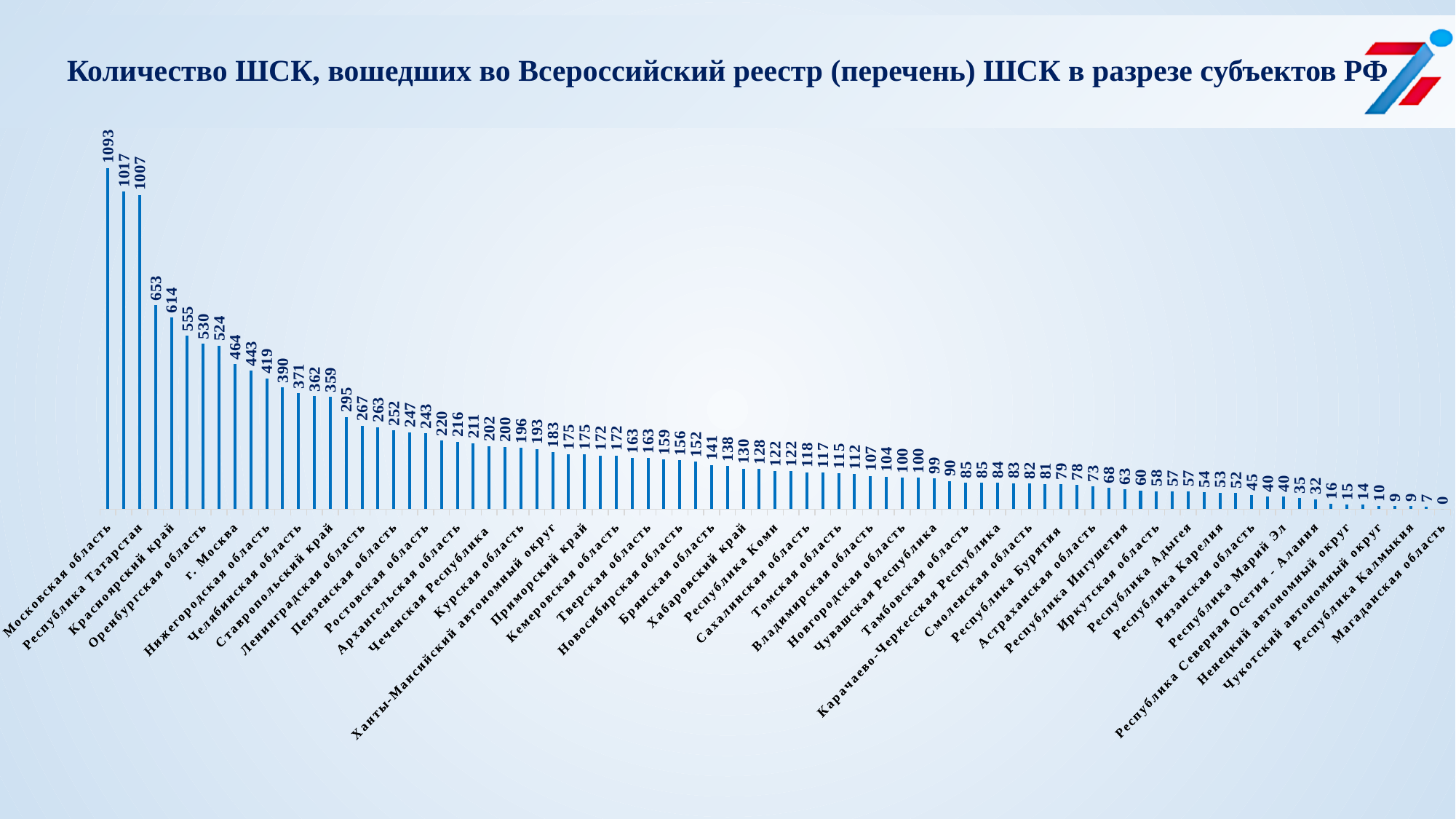
Is the value for Республика Татарстан greater or less than 1000? greater Do the values rise or fall moving from left to right along the x axis? fall What is the value shown for Магаданская область? 0 Which region has the lowest value in the chart? Магаданская область What is the value shown for Московская область? 1093 Is the value for Чукотский автономный округ greater or less than 50? less What type of chart is shown on the slide? bar chart What is the second-highest value labelled on the chart? 1017 Is the value for г. Москва greater or less than 600? less What is the title of the chart? Количество ШСК, вошедших во Всероссийский реестр (перечень) ШСК в разрезе субъектов РФ Which region has the highest number of ШСК in the chart? Московская область What is the difference between the highest value (1093) and the second-highest value (1017)? 76